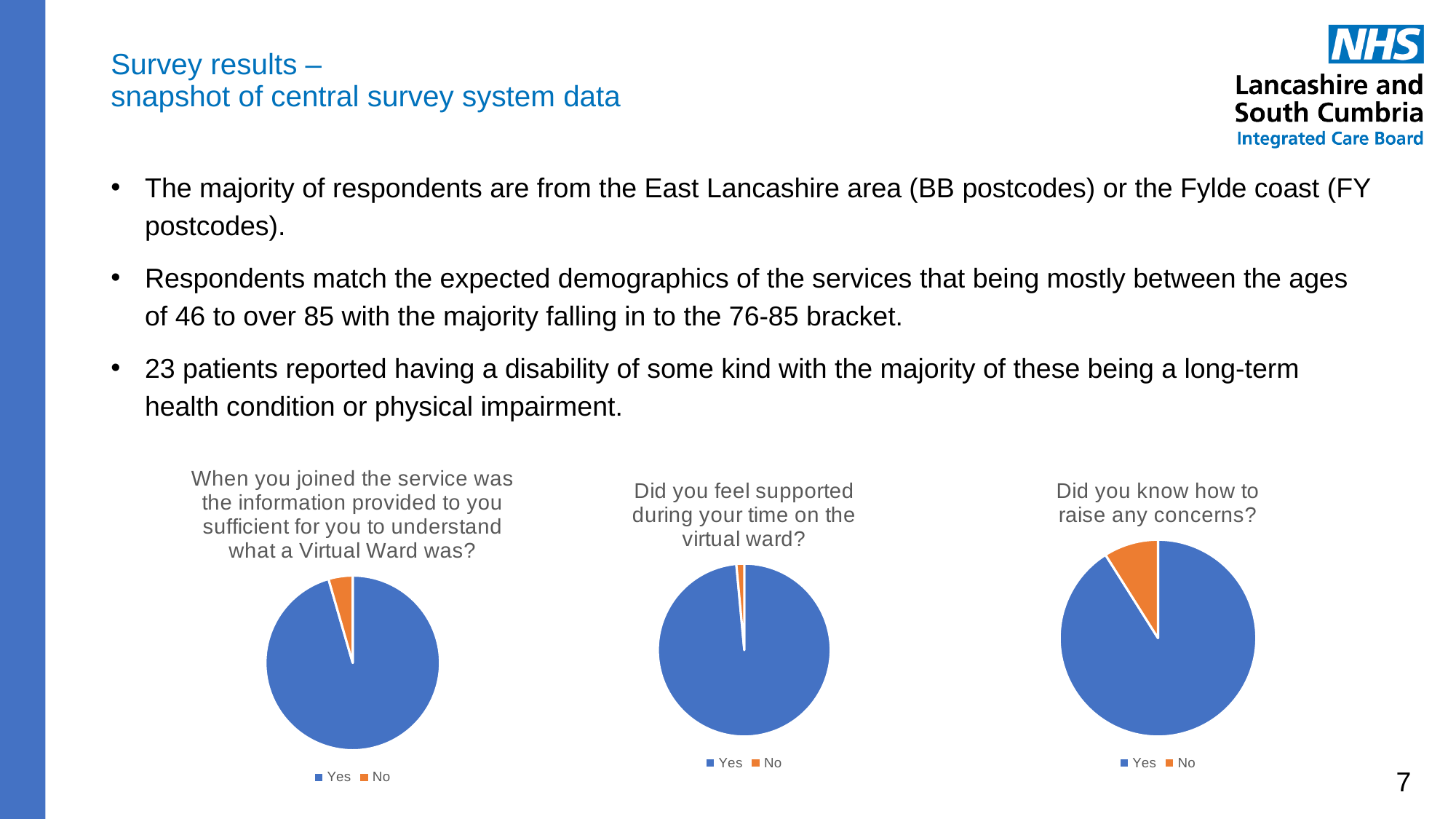
What is the title of the right-hand pie chart on the slide? Did you know how to raise any concerns? In the chart titled "Did you feel supported during your time on the virtual ward?", which response has the smallest slice? No In the left-hand pie chart about whether the information provided was sufficient to understand what a Virtual Ward was, which response has the largest slice? Yes In the chart titled "Did you know how to raise any concerns?", which response has the largest slice? Yes What colour represents the "No" response in the pie charts on the slide? orange In the chart titled "Did you know how to raise any concerns?", which response has the smallest slice? No How many entries does the legend list for the chart titled "Did you feel supported during your time on the virtual ward?"? 2 How many slices does the chart titled "Did you know how to raise any concerns?" have? 2 In the left-hand pie chart about whether the information provided was sufficient to understand what a Virtual Ward was, which response has the larger share: Yes or No? Yes How many pie charts are shown on the slide? 3 What kind of chart is the chart titled "Did you feel supported during your time on the virtual ward?"? pie chart